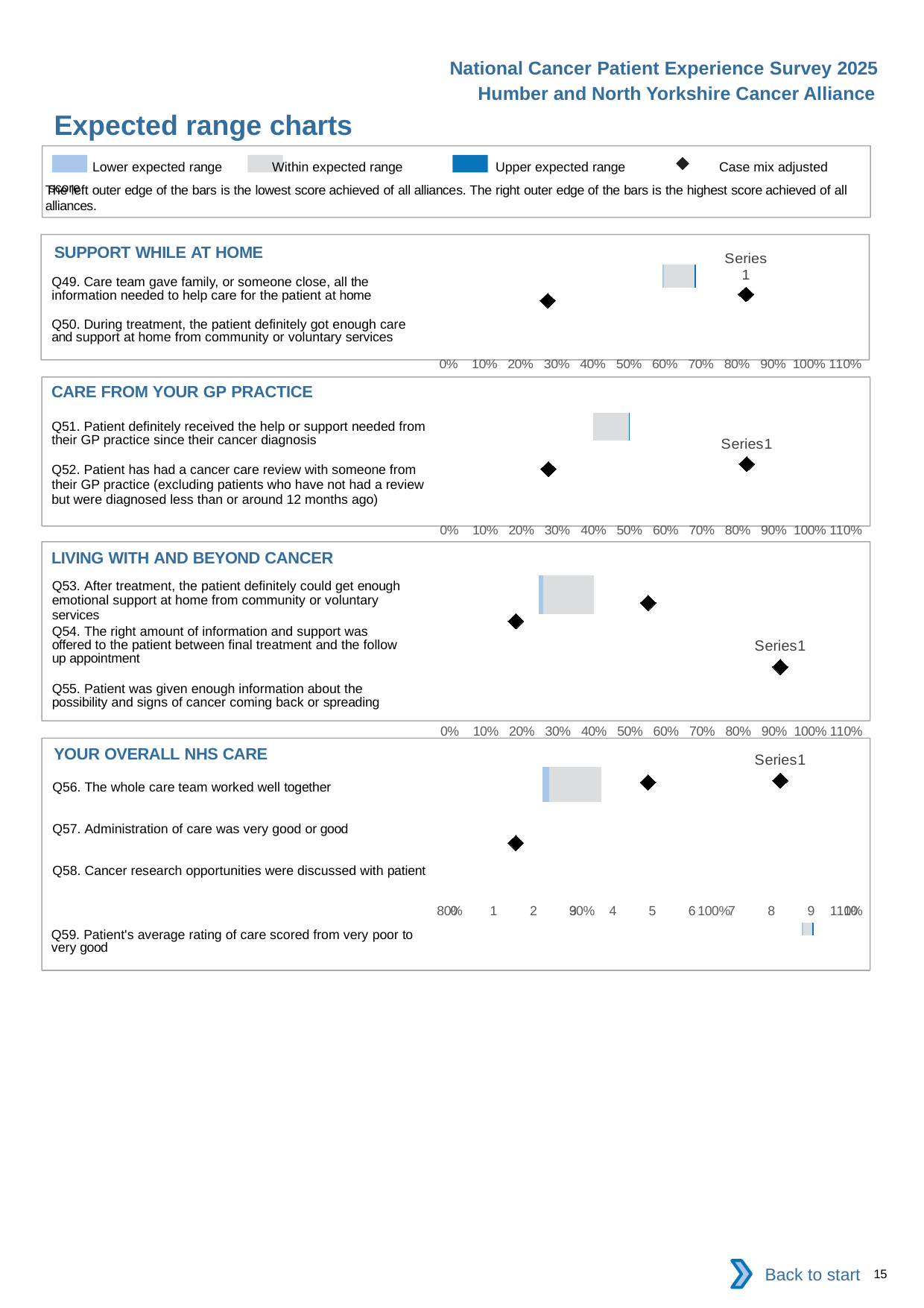
How many questions are listed in the SUPPORT WHILE AT HOME chart? 2 What is the highest tick label shown on the x axis of the SUPPORT WHILE AT HOME chart? 110% In the YOUR OVERALL NHS CARE chart, is the leftmost diamond marker greater or less than 30%? less How many entries does the legend at the top of the slide list? 4 How many questions are listed in the YOUR OVERALL NHS CARE chart? 4 According to the legend, what does the black diamond marker represent? Case mix adjusted score How many chart sections are shown on the slide? 4